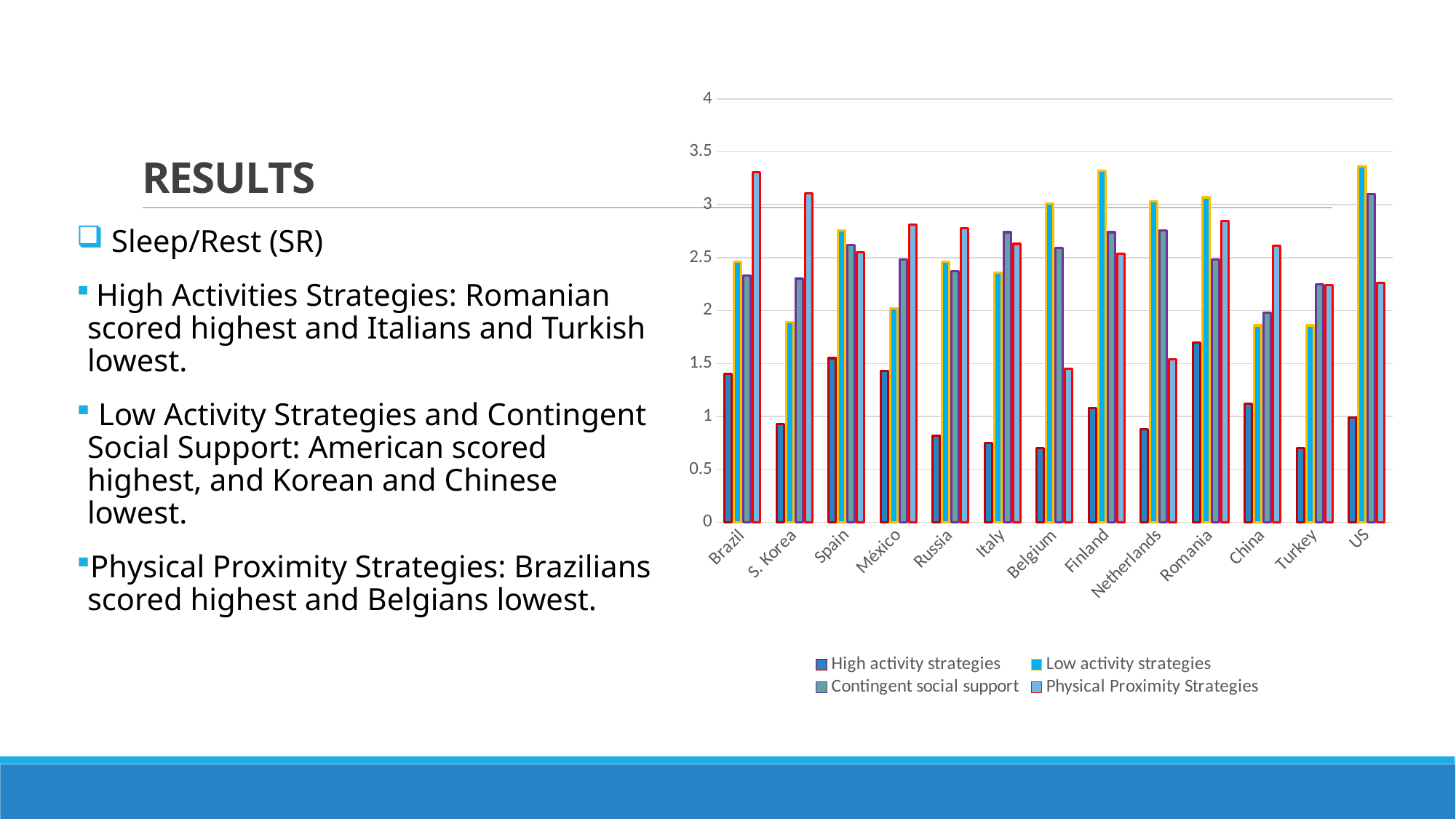
Which country has the highest value for Contingent social support? US For Brazil, which is larger: Physical Proximity Strategies or High activity strategies? Physical Proximity Strategies Which country has the highest value for Physical Proximity Strategies? Brazil Is the value for High activity strategies in S. Korea greater or less than 1? less How many countries are shown on the x axis of the chart? 13 What kind of chart is shown on the slide? bar chart How many series does the chart's legend list? 4 Is the value for Low activity strategies in China greater or less than 2? less Which series is shown in the legend with the dark blue colour? High activity strategies Which country has the highest value for High activity strategies? Romania Is the value for Physical Proximity Strategies in Belgium greater or less than 2? less